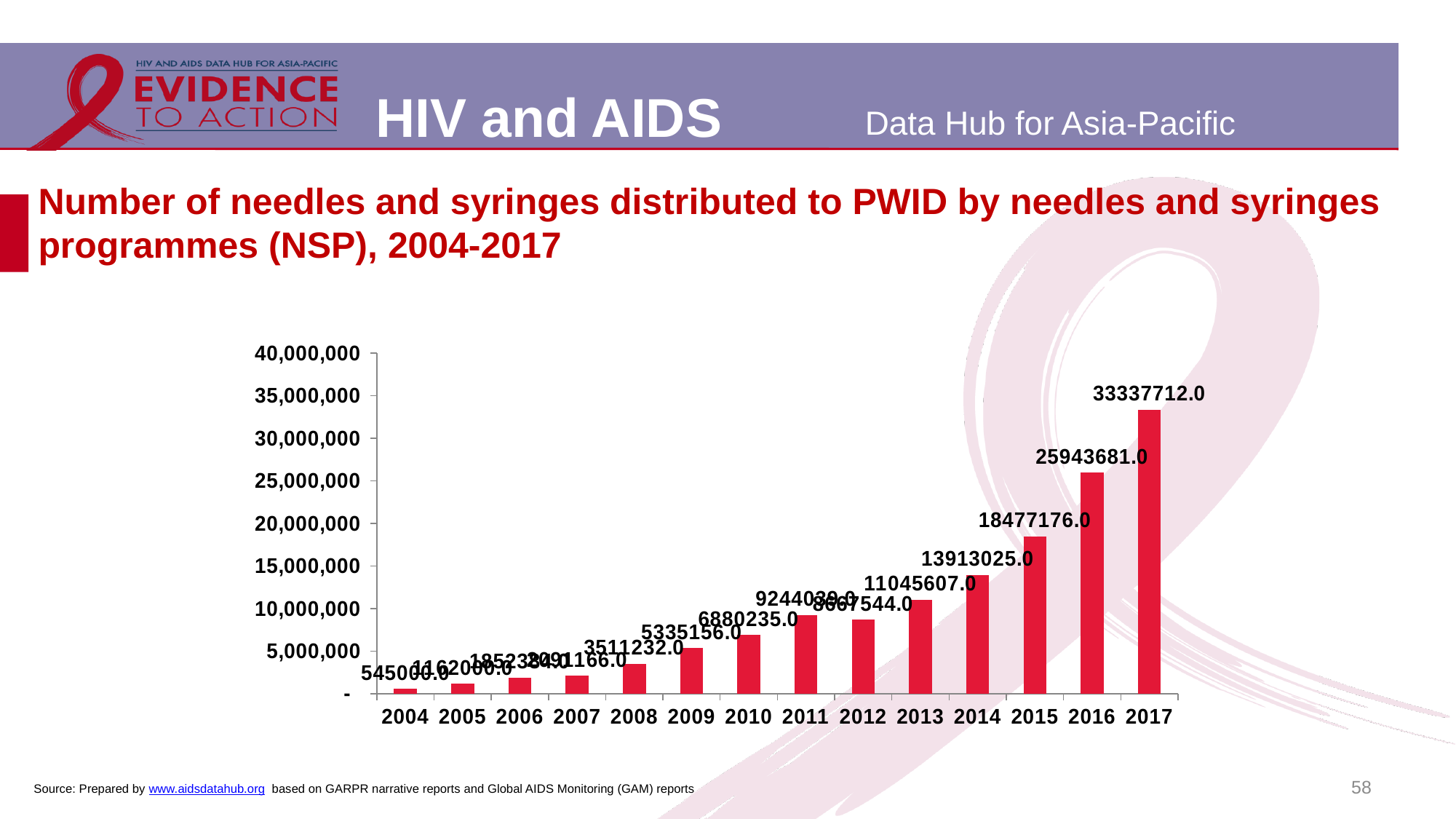
What is the value shown for 2013? 11045607.0 Which year has a larger value, 2011 or 2012? 2011 How many years are shown on the x axis of the chart? 14 What is the number of needles and syringes distributed in 2016? 25943681.0 What is the value shown for 2010? 6880235.0 Which year has the lowest number of needles and syringes distributed? 2004 What is the difference between the values for 2017 and 2016? 7394031.0 What is the number of needles and syringes distributed in 2017? 33337712.0 What kind of chart is shown on the slide? bar chart What is the value shown for 2015? 18477176.0 Is the value for 2011 greater or less than 10,000,000? less Which year has the highest number of needles and syringes distributed? 2017